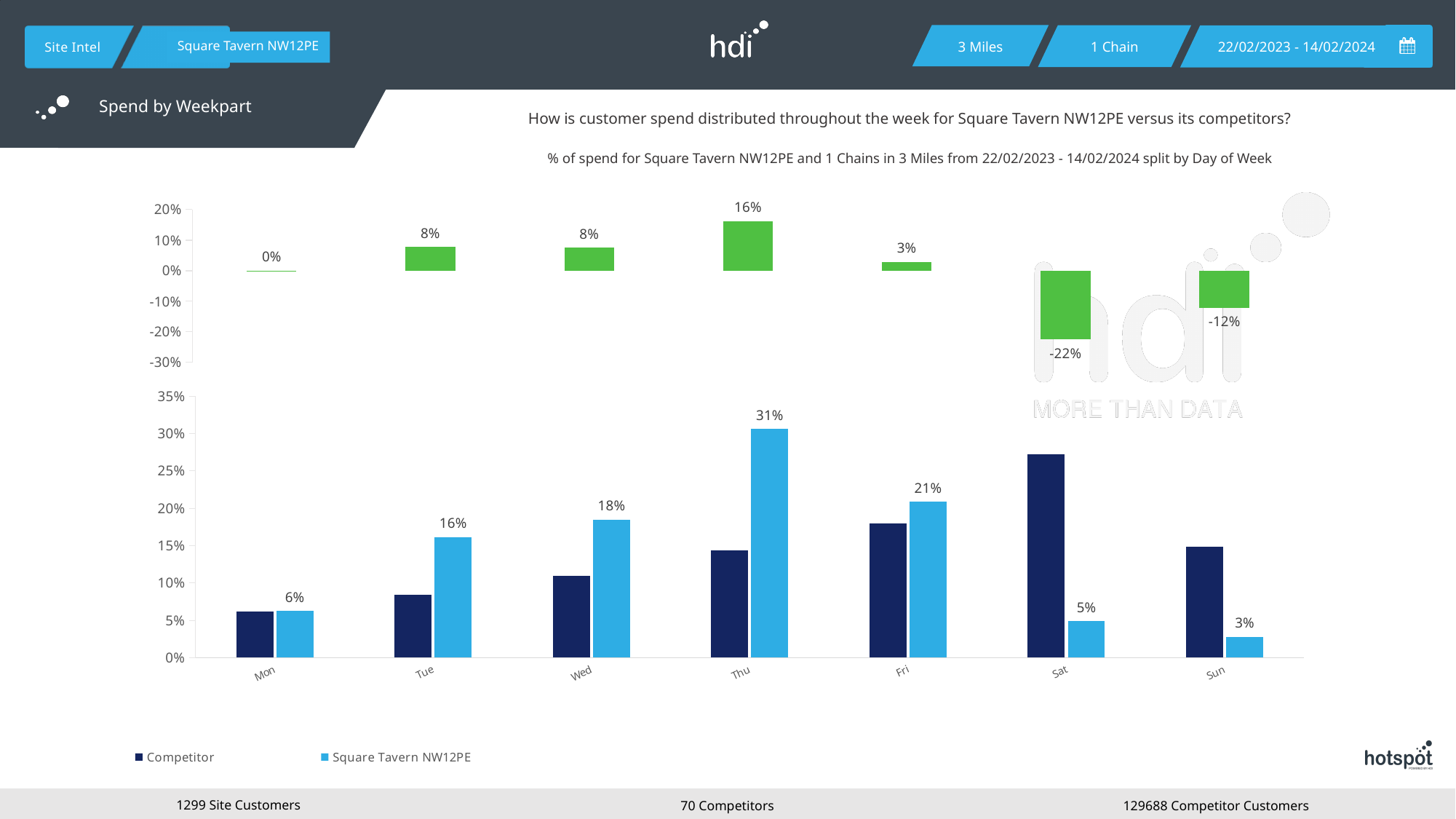
In the bottom chart, is the Competitor value for Sat greater or less than 25%? greater In the top chart, what is the value shown for Sat? -22% In the bottom chart, what is the value for Square Tavern NW12PE on Sun? 3% In the bottom chart, which is larger on Sat: the Competitor value or the Square Tavern NW12PE value? Competitor In the bottom chart, what is the value for Square Tavern NW12PE on Thu? 31% In the bottom chart, what is the difference between the Square Tavern NW12PE values for Thu and Fri? 10% In the bottom chart, which day has the highest value for Square Tavern NW12PE? Thu How many series does the legend of the bottom chart list? 2 In the bottom chart, which day has the lowest value for Square Tavern NW12PE? Sun In the top chart, which day has the highest value? Thu What kind of chart is the bottom chart? Bar chart How many days of the week are shown on the x axis of the bottom chart? 7